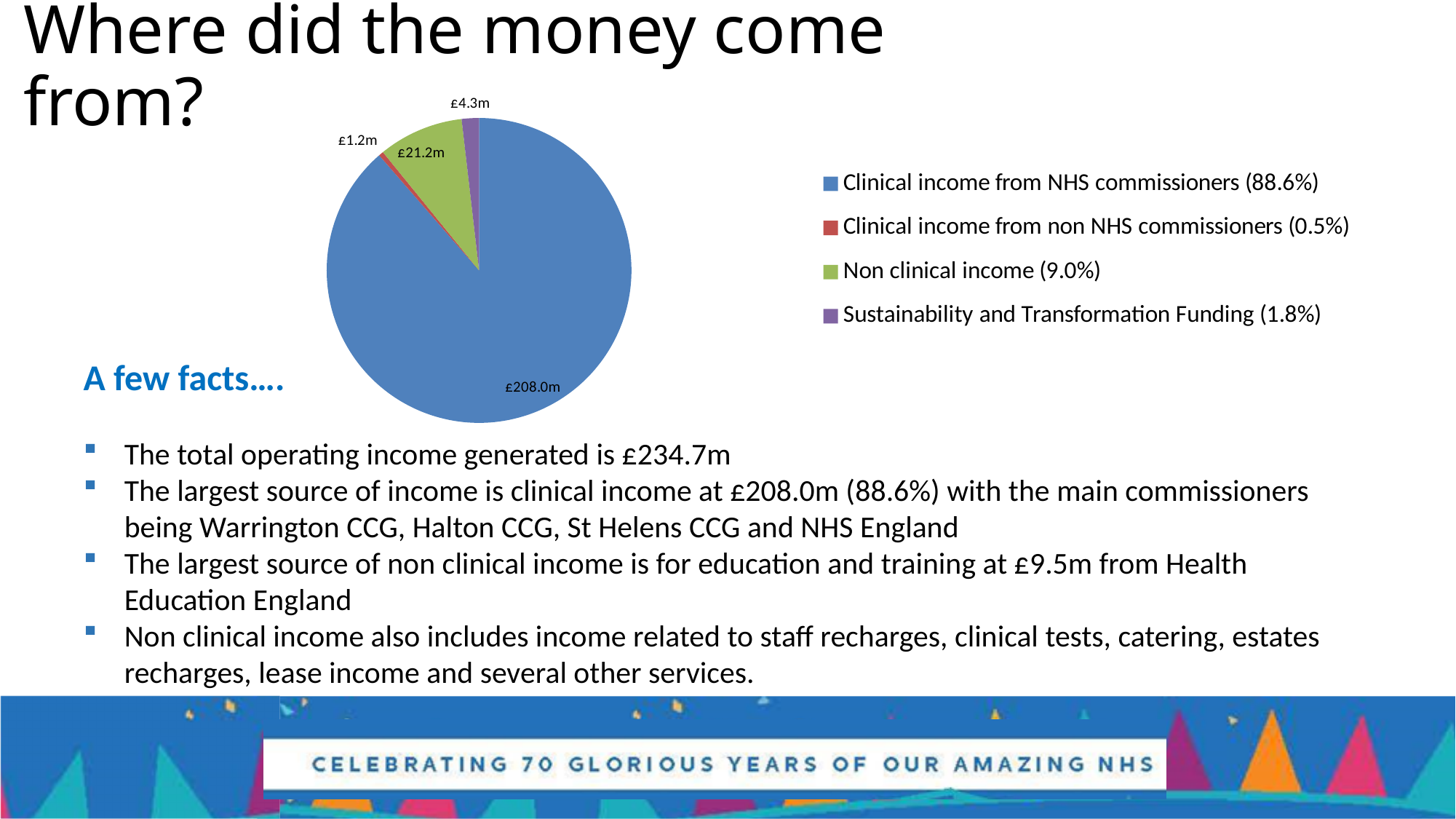
What is the difference between the Non clinical income slice and the Sustainability and Transformation Funding slice? £16.9m What is the value of the Non clinical income slice? £21.2m How many slices does the pie chart have? 4 What share of the pie does Sustainability and Transformation Funding represent, as shown in the legend? 1.8% What is the value of the Clinical income from non NHS commissioners slice? £1.2m What kind of chart is shown on the slide? Pie chart What is the value of the Sustainability and Transformation Funding slice? £4.3m What share of the pie does Non clinical income represent, as shown in the legend? 9.0% Which category has the smallest slice of the pie? Clinical income from non NHS commissioners What is the value of the Clinical income from NHS commissioners slice? £208.0m Which category has the largest slice of the pie? Clinical income from NHS commissioners Which is larger: Non clinical income or Sustainability and Transformation Funding? Non clinical income